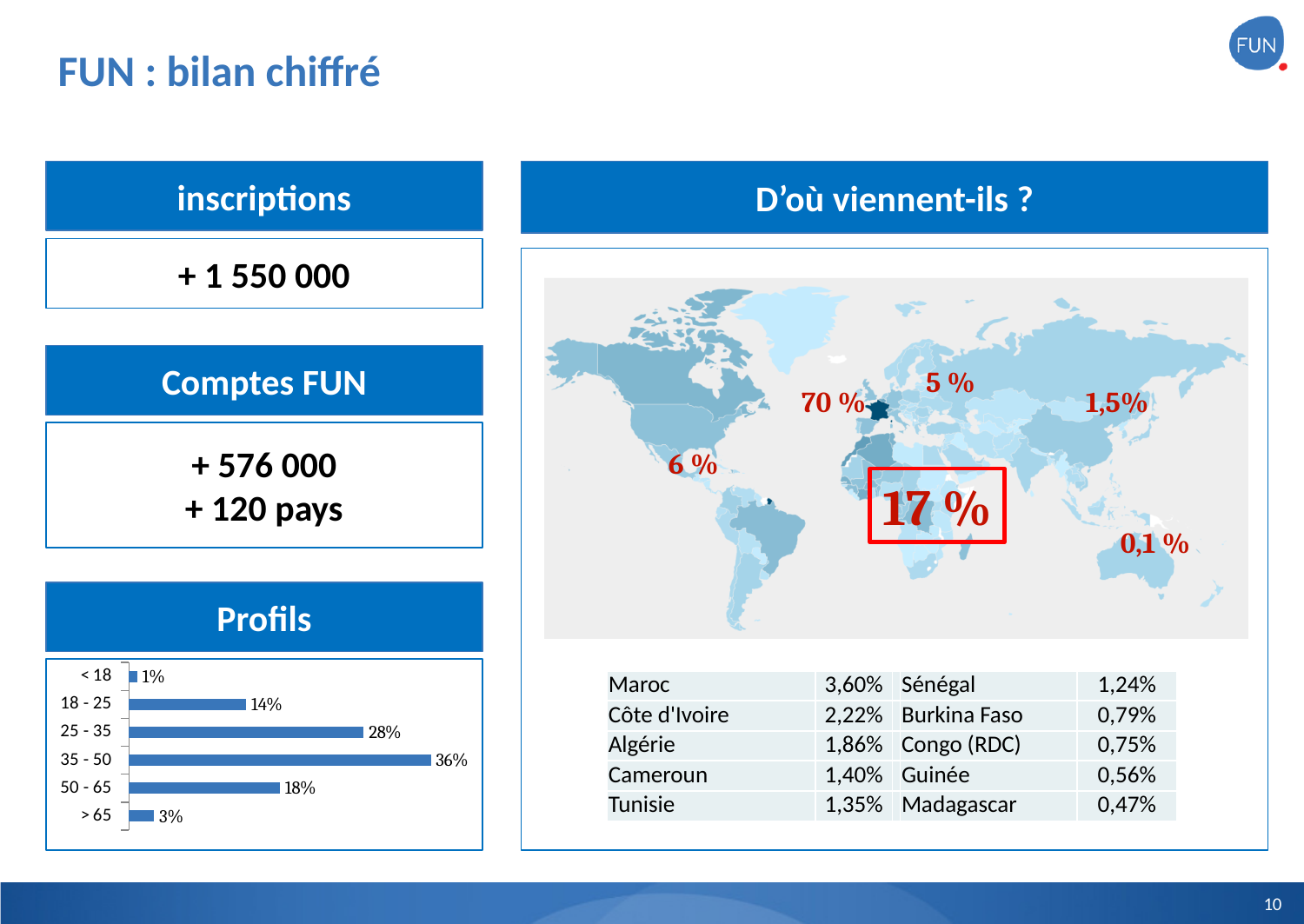
In the Profils bar chart, what is the value for the 50 - 65 age group? 18% In the Profils bar chart, which age group has the highest value? 35 - 50 In the Profils bar chart, what is the value for the 18 - 25 age group? 14% In the Profils bar chart, what is the value for the > 65 age group? 3% What kind of chart is shown under the Profils heading? Bar chart In the Profils bar chart, what is the difference between the 35 - 50 and 25 - 35 age groups? 8% In the Profils bar chart, what is the value for the 35 - 50 age group? 36% In the Profils bar chart, what is the difference between the 50 - 65 and 18 - 25 age groups? 4% In the Profils bar chart, which age group has the lowest value? < 18 What is the title of the section containing the bar chart on the slide? Profils How many age groups are shown in the Profils bar chart? 6 In the Profils bar chart, which is larger: the value for 25 - 35 or the value for 50 - 65? 25 - 35